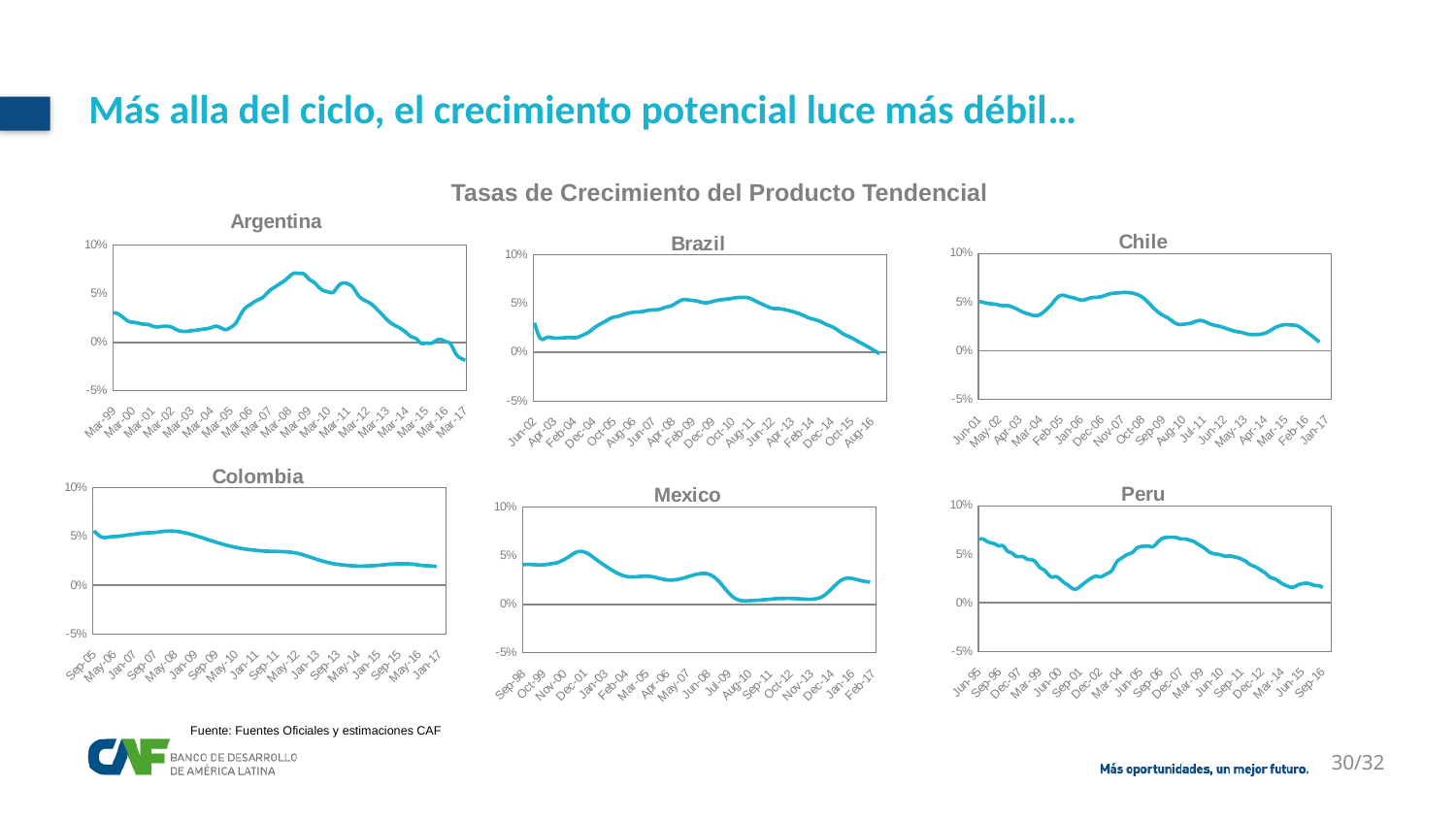
In the Peru chart, is the value at Sep-01 greater or less than 5%? less In the Mexico chart, is the value at Aug-10 greater or less than 5%? less In the Chile chart, is the value at Oct-07 greater or less than 5%? greater What is the overall title above the six charts? Tasas de Crecimiento del Producto Tendencial In the Colombia chart, do the values overall rise or fall from Sep-05 to Jan-17? fall What kind of chart is used for the Argentina panel? line chart How many country charts are shown on the slide? 6 What is the highest value shown on the vertical axis of the Peru chart? 10%